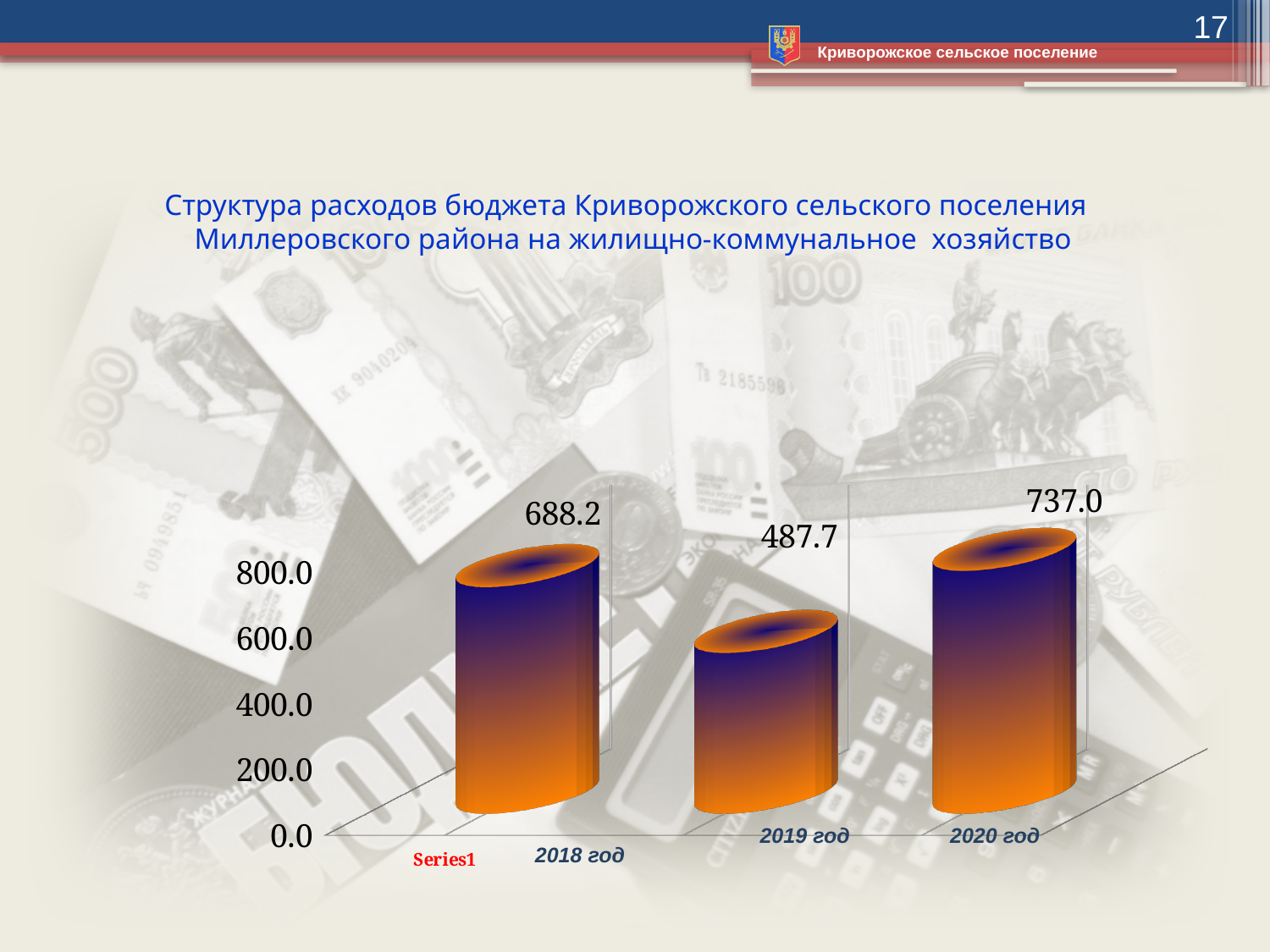
What is the difference between the values for 2020 год and 2018 год? 48.8 What kind of chart is shown on the slide? bar chart What is the value for 2018 год? 688.2 What is the value for 2020 год? 737.0 What is the value for 2019 год? 487.7 Is the value for 2019 год greater or less than 600.0? less Which year has the lowest value? 2019 год What is the highest tick value shown on the vertical axis? 800.0 Which is larger, the value for 2018 год or the value for 2019 год? 2018 год What is the difference between the values for 2018 год and 2019 год? 200.5 Which year has the highest value? 2020 год How many years are shown on the chart? 3